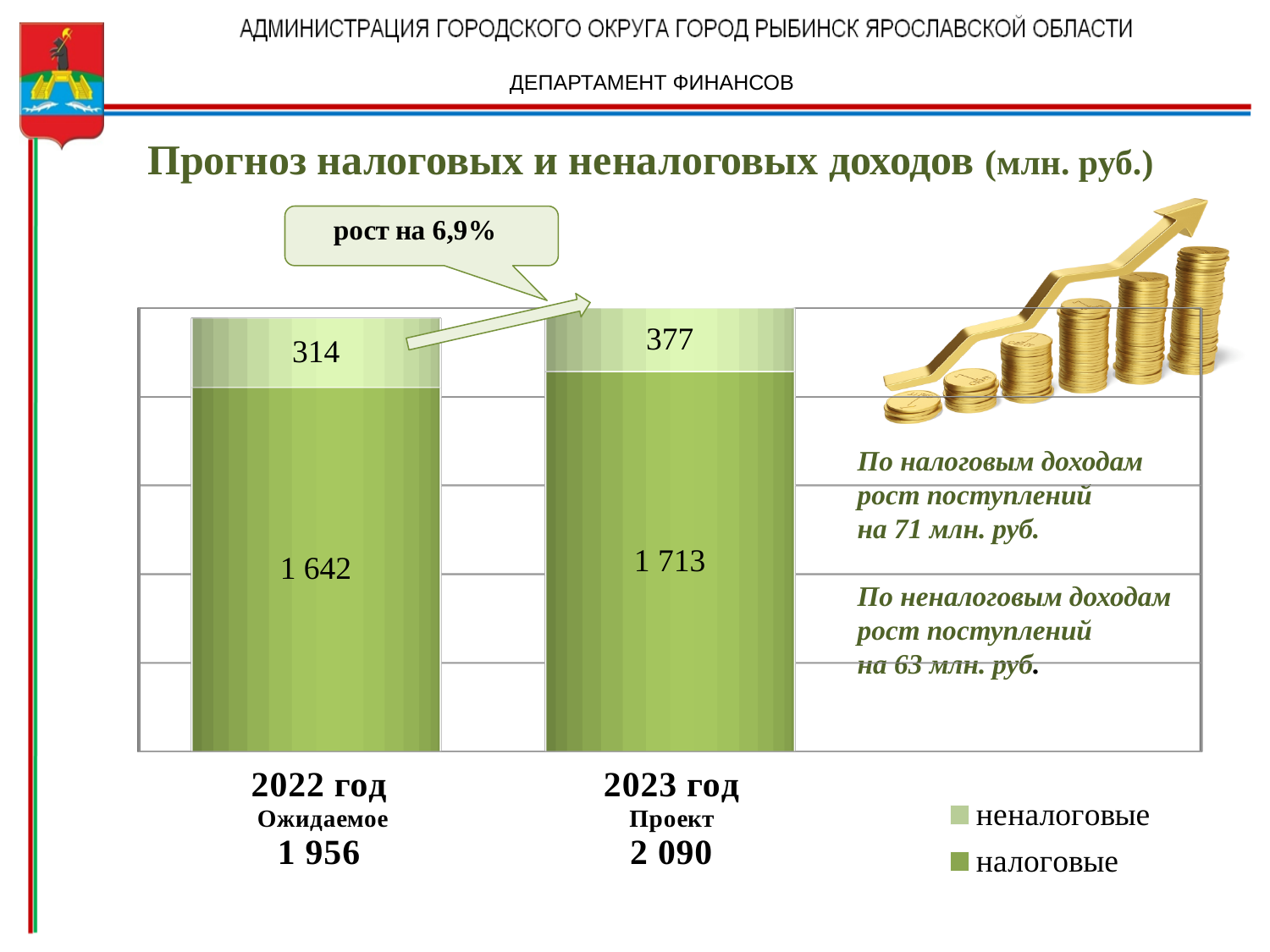
What is the value of налоговые доходы for 2023 год? 1 713 What is the difference between неналоговые доходы in 2023 год and 2022 год? 63 What kind of chart is shown on the slide? Stacked bar chart What is the total of the stacked bar for 2022 год? 1 956 How many series does the legend list? 2 What is the title of the chart? Прогноз налоговых и неналоговых доходов (млн. руб.) What is the value of налоговые доходы for 2022 год? 1 642 What is the value of неналоговые доходы for 2022 год? 314 What is the total of the stacked bar for 2023 год? 2 090 What is the value of неналоговые доходы for 2023 год? 377 By how much do налоговые доходы in 2023 год exceed those in 2022 год? 71 Which year has the larger value for неналоговые доходы, 2022 год or 2023 год? 2023 год